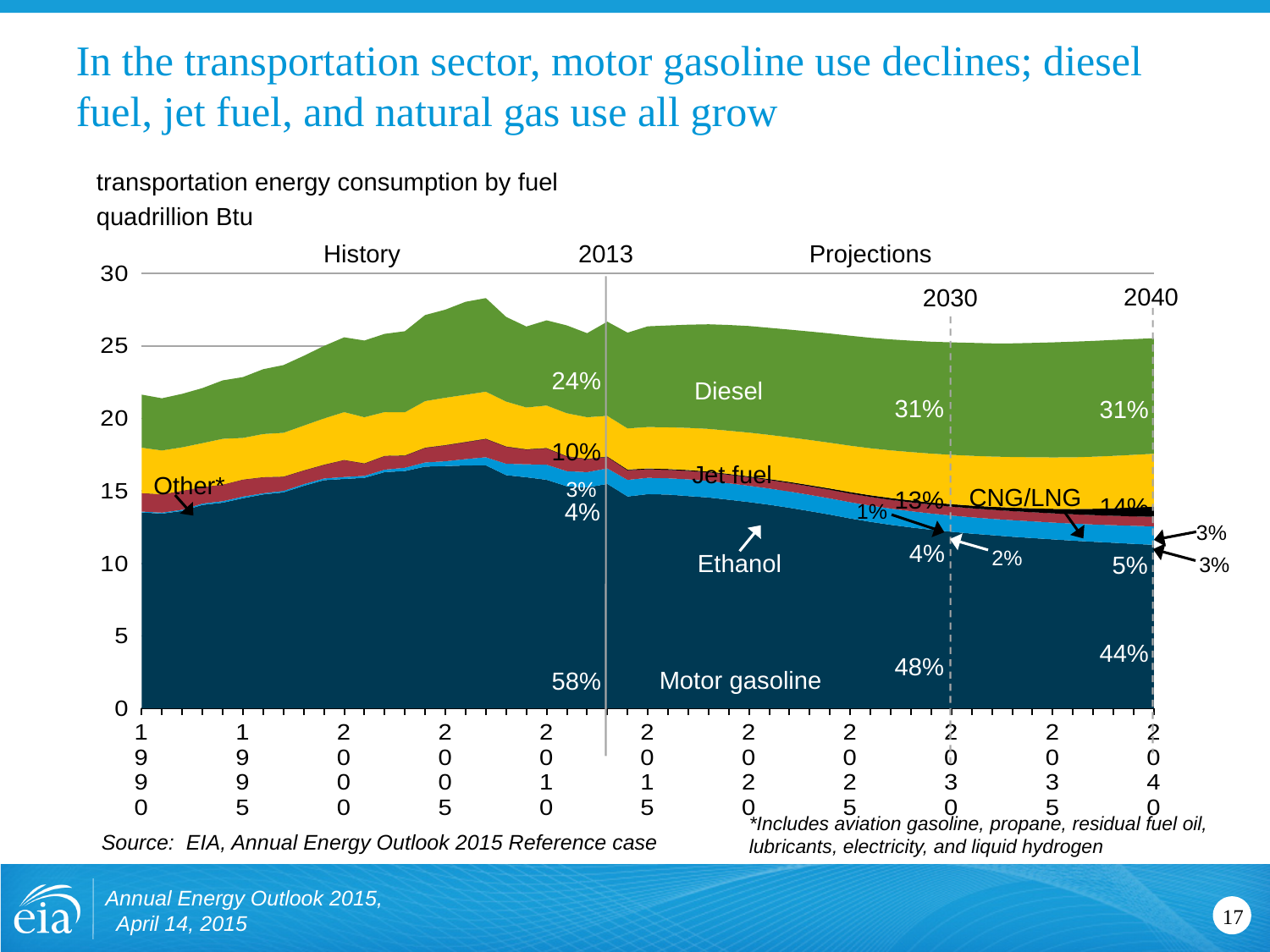
What share of transportation energy consumption is projected for motor gasoline in 2040? 44% What kind of chart is shown on the slide? Stacked area chart What share of transportation energy consumption is projected for jet fuel in 2040? 14% By how many percentage points does the diesel share change between 2013 and 2030? 7 percentage points Does the motor gasoline share rise or fall from 2013 to 2040? Fall What share of transportation energy consumption does jet fuel account for in 2013? 10% What share of transportation energy consumption is projected for diesel in 2030? 31% What share of transportation energy consumption does motor gasoline account for in 2013? 58% Is total transportation energy consumption in 1990 greater or less than 25 quadrillion Btu? less What share of transportation energy consumption is projected for ethanol in 2040? 5% What share of transportation energy consumption is projected for CNG/LNG in 2030? 1% Which fuel has the largest share of transportation energy consumption in 2040? Motor gasoline